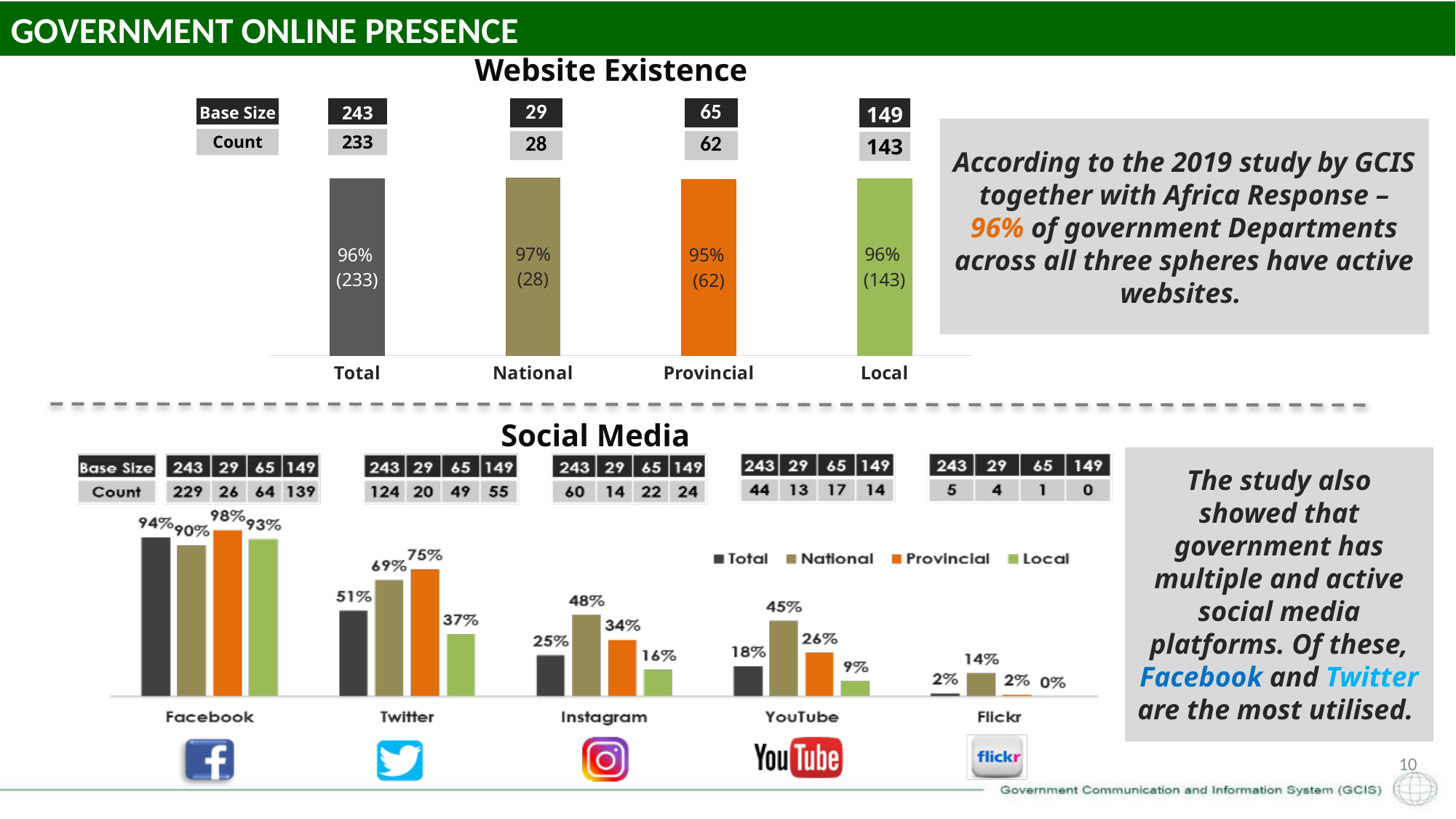
In the Social Media chart, which is larger for Twitter: the National value or the Local value? National In the Social Media chart, what is the difference between the National and Local values for Instagram? 32% In the Website Existence chart, what is the count shown for Local? 143 What kind of chart is the Social Media chart? Bar chart In the Social Media chart, what is the Provincial value for Twitter? 75% In the Social Media chart, how many series does the legend list? 4 In the Website Existence chart, which category has the lowest percentage? Provincial In the Social Media chart, which platform has the highest Total value? Facebook In the Social Media chart, how many platforms are shown on the x axis? 5 In the Website Existence chart, what percentage is shown for National? 97% In the Social Media chart, what is the Local value for YouTube? 9% In the Website Existence chart, how many categories are shown on the x axis? 4